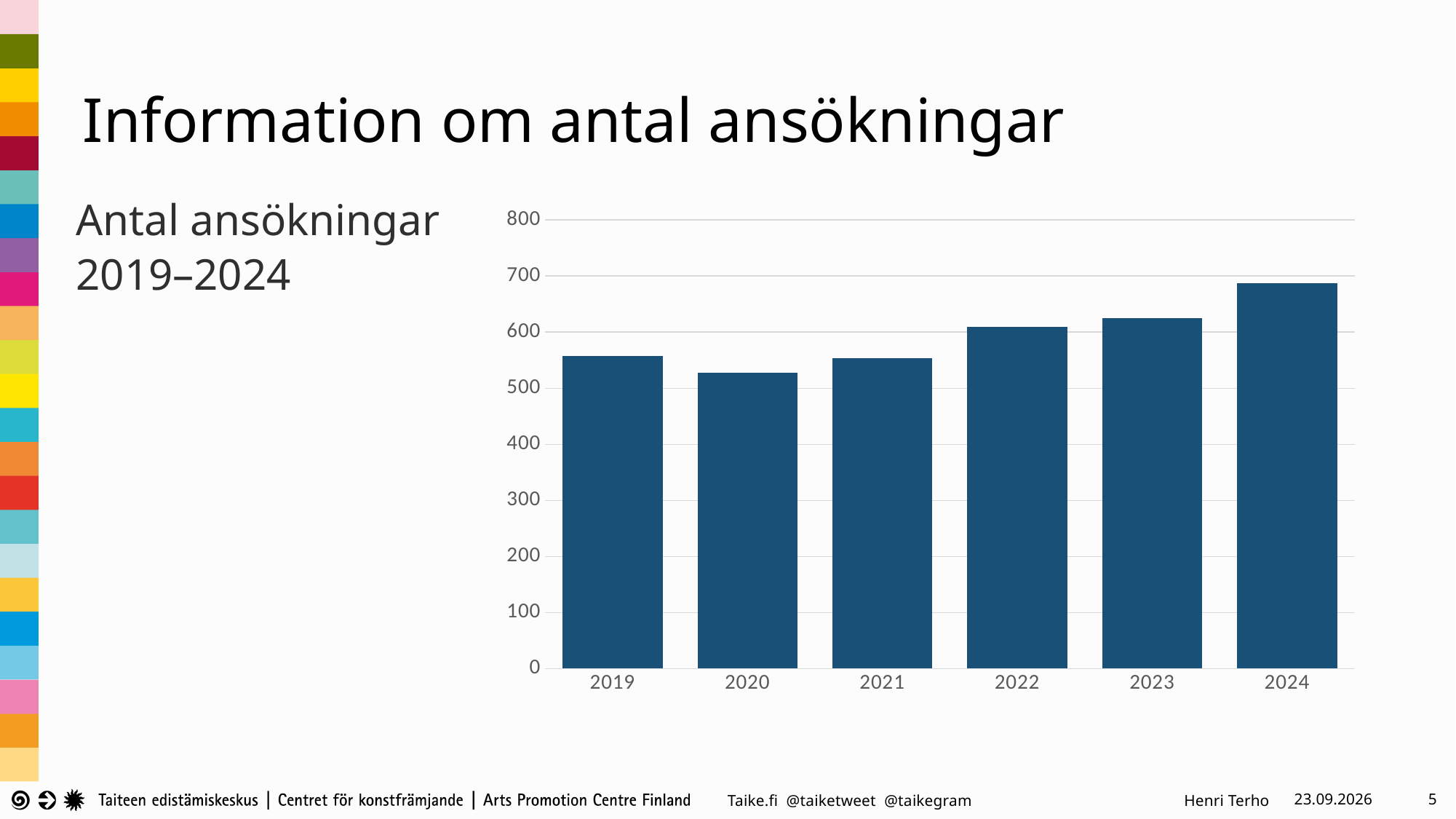
Is the value for 2024 greater or less than 700? less What kind of chart is shown on the slide? bar chart From 2020 to 2024, do the values in the chart rise or fall? rise Is the value for 2024 greater or less than 600? greater Which is larger, the value for 2020 or the value for 2022? 2022 Is the value for 2021 greater or less than 600? less Which year has the lowest number of applications in the chart? 2020 How many years are shown on the x axis of the chart? 6 What is the subtitle shown to the left of the chart? Antal ansökningar 2019–2024 Which year has the highest number of applications in the chart? 2024 Which is larger, the value for 2019 or the value for 2024? 2024